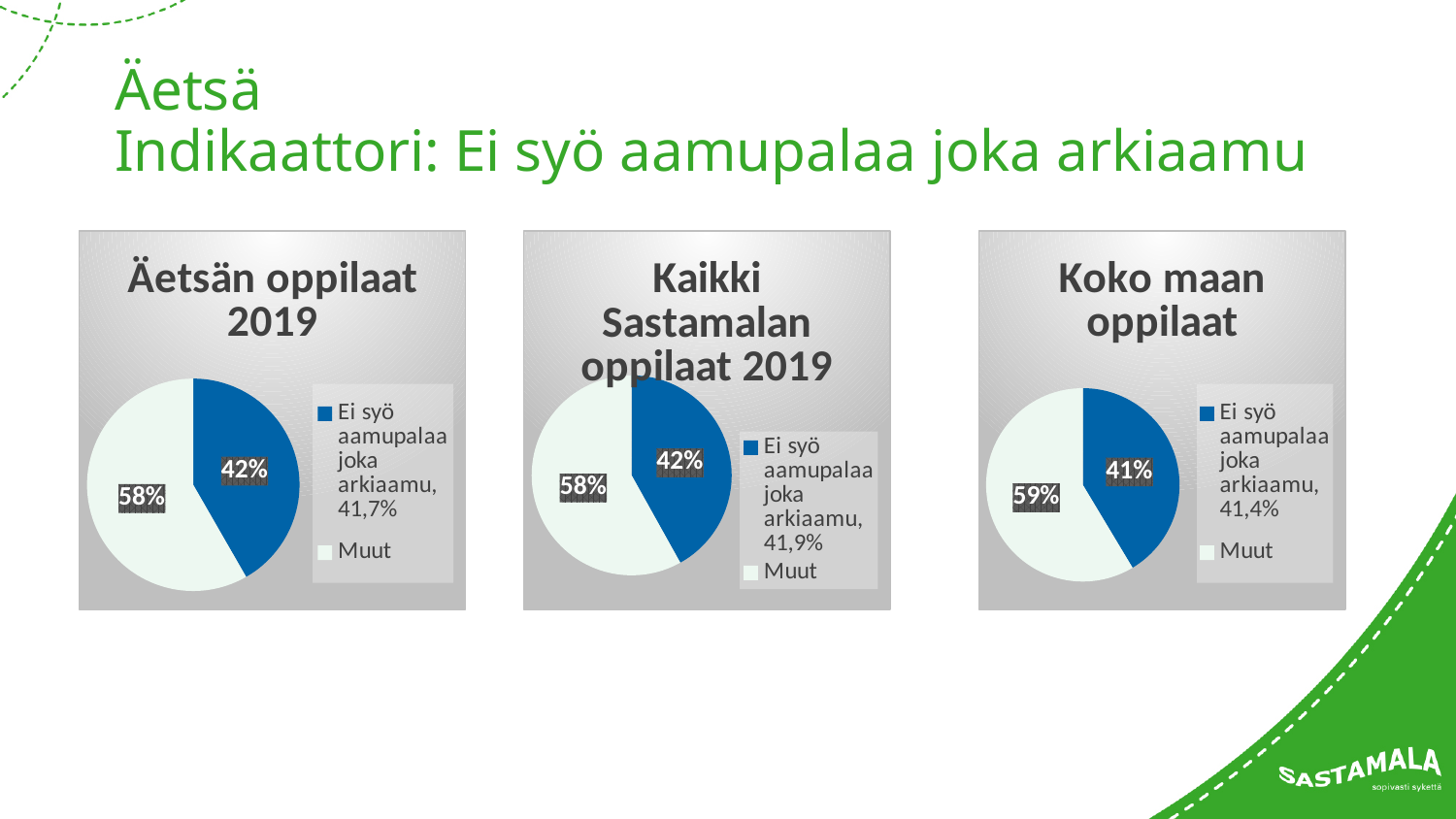
In the 'Kaikki Sastamalan oppilaat 2019' chart, which slice is larger: 'Muut' or 'Ei syö aamupalaa joka arkiaamu'? Muut In the 'Äetsän oppilaat 2019' chart, what percentage is shown for the 'Ei syö aamupalaa joka arkiaamu' slice? 42% How many slices does the 'Kaikki Sastamalan oppilaat 2019' pie chart have? 2 In the 'Koko maan oppilaat' chart, what percentage is shown for the 'Muut' slice? 59% What kind of chart is the 'Äetsän oppilaat 2019' chart? Pie chart In the 'Koko maan oppilaat' chart, what percentage is shown for the 'Ei syö aamupalaa joka arkiaamu' slice? 41% In the 'Koko maan oppilaat' chart, which slice is the largest? Muut In the 'Koko maan oppilaat' chart, what is the difference between the 'Muut' slice and the 'Ei syö aamupalaa joka arkiaamu' slice? 18% In the 'Äetsän oppilaat 2019' chart, which slice is the smallest? Ei syö aamupalaa joka arkiaamu In the 'Äetsän oppilaat 2019' chart, what percentage is shown for the 'Muut' slice? 58% In the 'Kaikki Sastamalan oppilaat 2019' chart, what percentage is shown for the 'Muut' slice? 58% How many pie charts are shown on the slide? 3